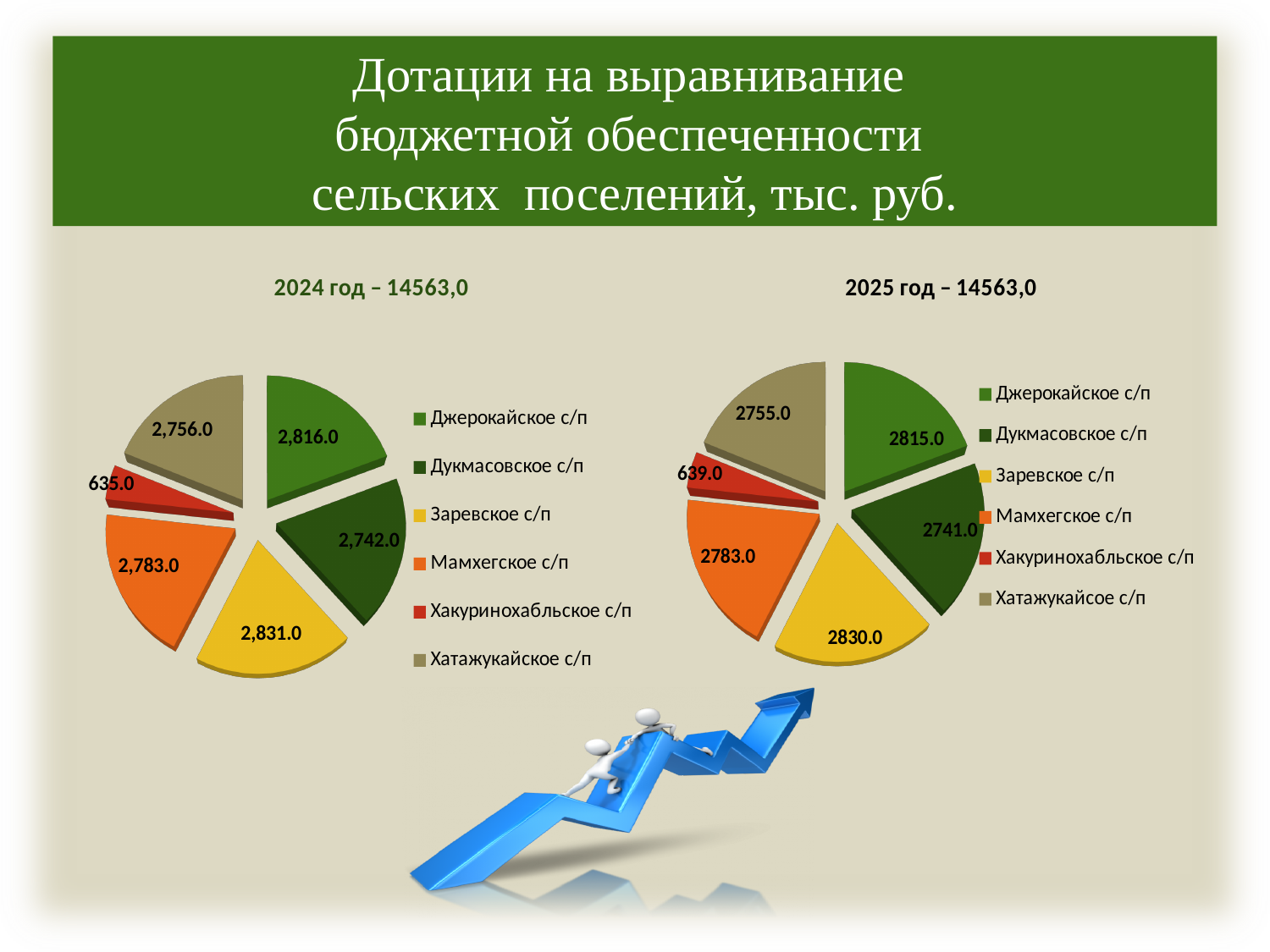
What total is shown in the heading above the 2025 chart? 14563,0 On the 2025 pie chart, what is the value for Заревское с/п? 2830.0 On the 2024 pie chart, which is larger: the value for Дукмасовское с/п or Хатажукайское с/п? Хатажукайское с/п On the 2025 pie chart, what is the value for Хакуринохабльское с/п? 639.0 On the 2025 pie chart, what is the difference between the values for Заревское с/п and Хакуринохабльское с/п? 2191.0 On the 2024 pie chart, what is the difference between the values for Заревское с/п and Дукмасовское с/п? 89.0 What type of chart is used for the 2024 data? Pie chart On the 2024 pie chart, what is the value for Мамхегское с/п? 2,783.0 On the 2024 pie chart, what is the value for Джерокайское с/п? 2,816.0 On the 2024 pie chart, which settlement has the smallest slice? Хакуринохабльское с/п On the 2025 pie chart, which settlement has the largest value? Заревское с/п How many slices does the 2025 pie chart have? 6